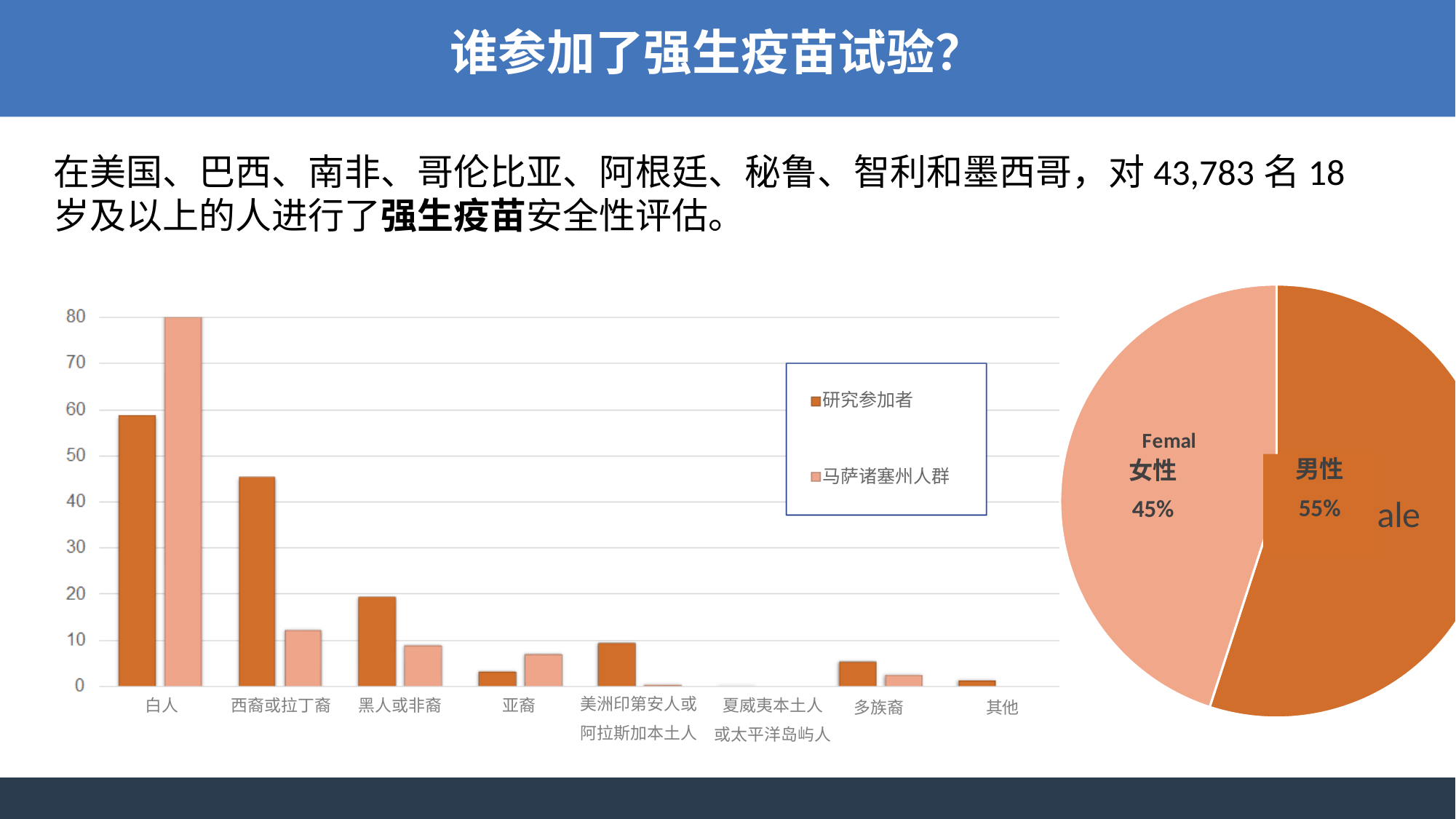
In the bar chart on the left, is the 研究参加者 value for 白人 greater or less than 50? greater In the bar chart on the left, for 亚裔, which series has the larger value, 研究参加者 or 马萨诸塞州人群? 马萨诸塞州人群 What kind of chart is the chart on the left of the slide? bar chart What kind of chart is the chart on the right of the slide? pie chart In the bar chart on the left, which category has the highest value for 研究参加者? 白人 In the pie chart on the right, what share is 男性? 55% In the bar chart on the left, how many series does the legend list? 2 In the bar chart on the left, which category has the highest value for 马萨诸塞州人群? 白人 In the pie chart on the right, what is the difference between the 男性 share and the 女性 share? 10% In the bar chart on the left, how many categories are shown on the x axis? 8 In the bar chart on the left, is the 马萨诸塞州人群 value for 西裔或拉丁裔 greater or less than 20? less In the bar chart on the left, for 黑人或非裔, which series has the larger value, 研究参加者 or 马萨诸塞州人群? 研究参加者